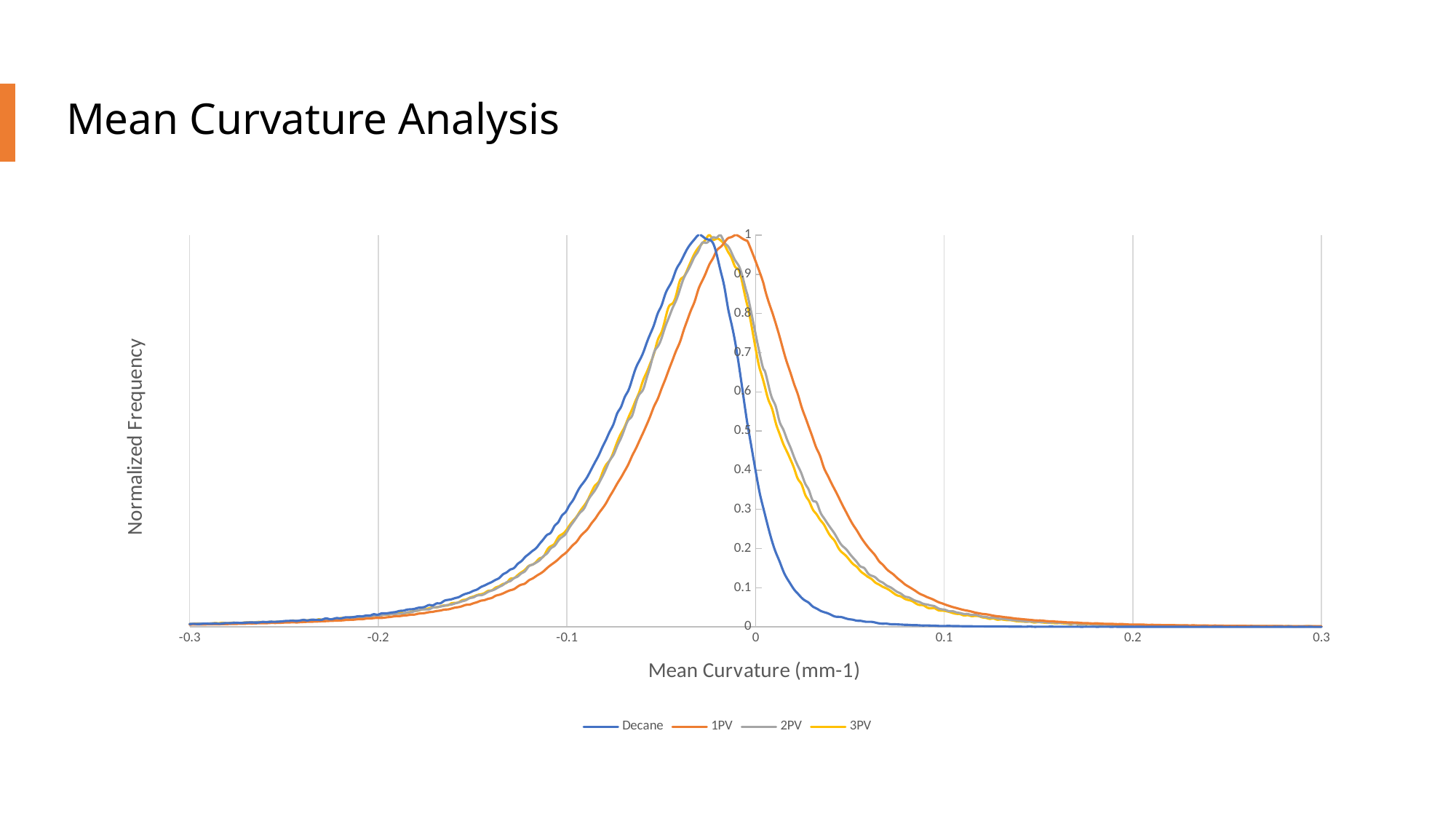
At a mean curvature of -0.05, which series has the higher value, Decane or 1PV? Decane What are the series names listed in the legend? Decane, 1PV, 2PV, 3PV What is the title of the x axis? Mean Curvature (mm-1) Is the value of the 1PV series at a mean curvature of -0.1 greater or less than 0.3? less Is the value of the Decane series at a mean curvature of -0.1 greater or less than 0.2? greater What kind of chart is shown on the slide? line chart Do the values of the Decane series rise or fall as mean curvature increases from 0 to 0.3? fall How many tick labels are shown on the x axis? 7 How many series does the legend list? 4 At a mean curvature of 0.05, which series has the higher value, Decane or 1PV? 1PV Is the value of the 1PV series at a mean curvature of 0 greater or less than 0.9? greater